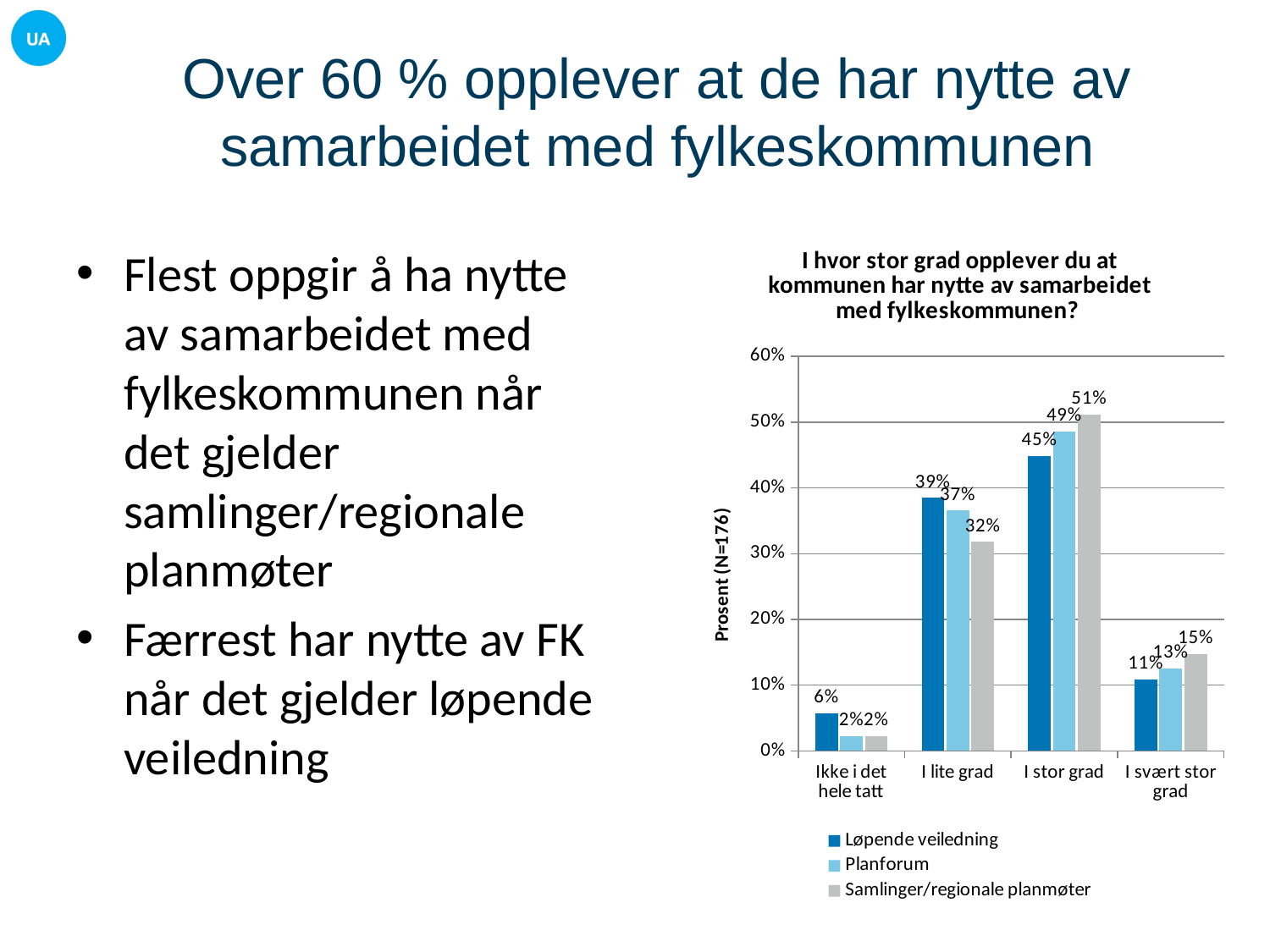
What is the value for Samlinger/regionale planmøter in the 'I lite grad' category? 32% What is the y-axis label of the chart? Prosent (N=176) Which category has the highest value for Samlinger/regionale planmøter? I stor grad Is the value for Planforum in the 'I stor grad' category greater or less than 40%? greater What is the value for Løpende veiledning in the 'I stor grad' category? 45% What is the difference between Samlinger/regionale planmøter and Løpende veiledning in the 'I lite grad' category? 7% What is the value for Planforum in the 'I svært stor grad' category? 13% In the 'I stor grad' category, which is larger: Planforum or Løpende veiledning? Planforum What kind of chart is shown on the slide? Bar chart How many series does the legend list? 3 Which category has the lowest value for Løpende veiledning? Ikke i det hele tatt How many categories are shown on the x axis? 4